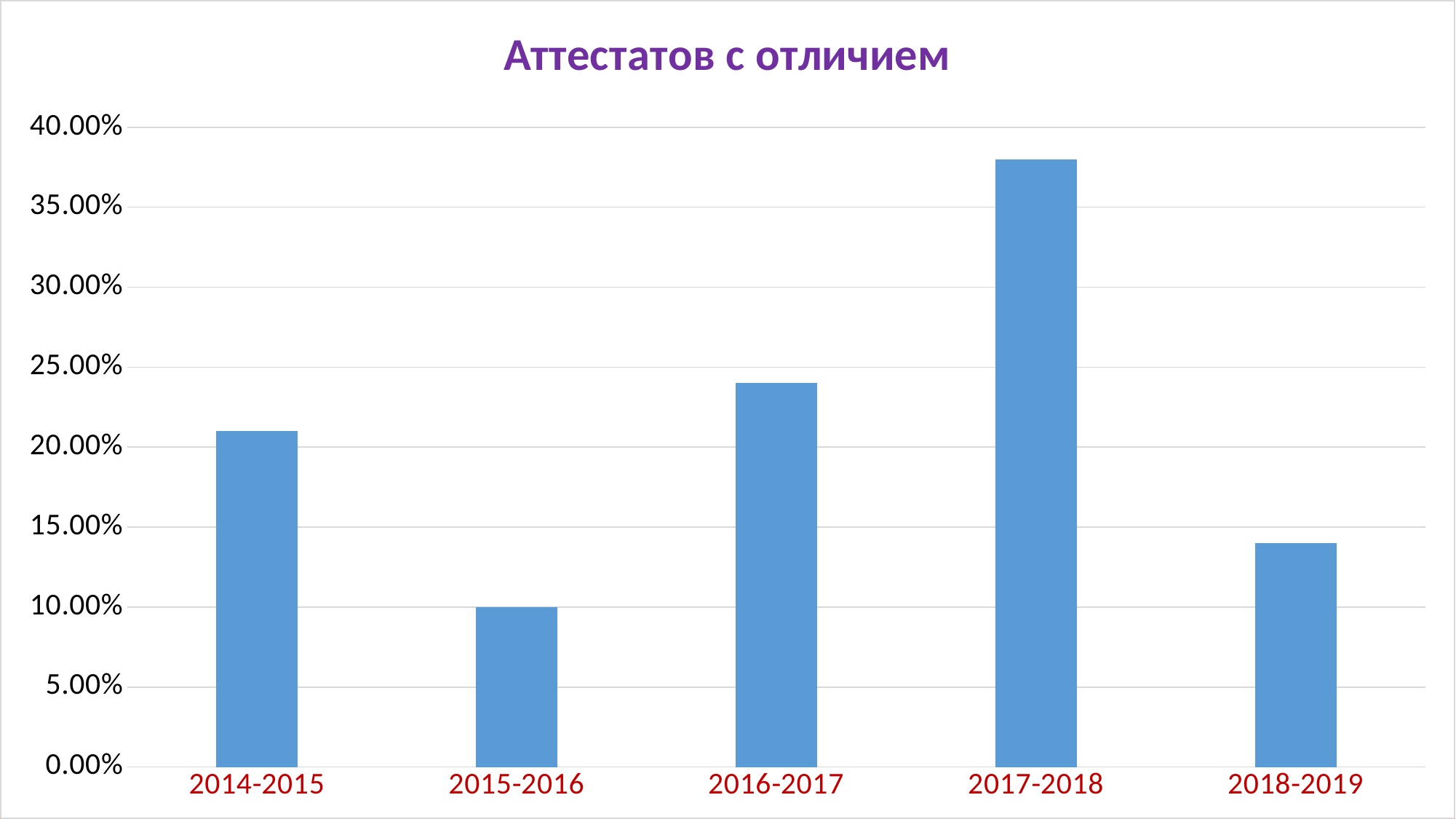
Which academic year has the lowest value? 2015-2016 What is the title of the chart? Аттестатов с отличием Is the value for 2018-2019 greater or less than 15.00%? less Which is larger, the value for 2018-2019 or the value for 2015-2016? 2018-2019 Is the value for 2014-2015 greater or less than 20.00%? greater Is the value for 2016-2017 greater or less than 25.00%? less What is the value for 2015-2016? 10.00% What kind of chart is shown on the slide? bar chart Which academic year has the highest value? 2017-2018 Which is larger, the value for 2016-2017 or the value for 2014-2015? 2016-2017 How many academic years are shown on the x axis? 5